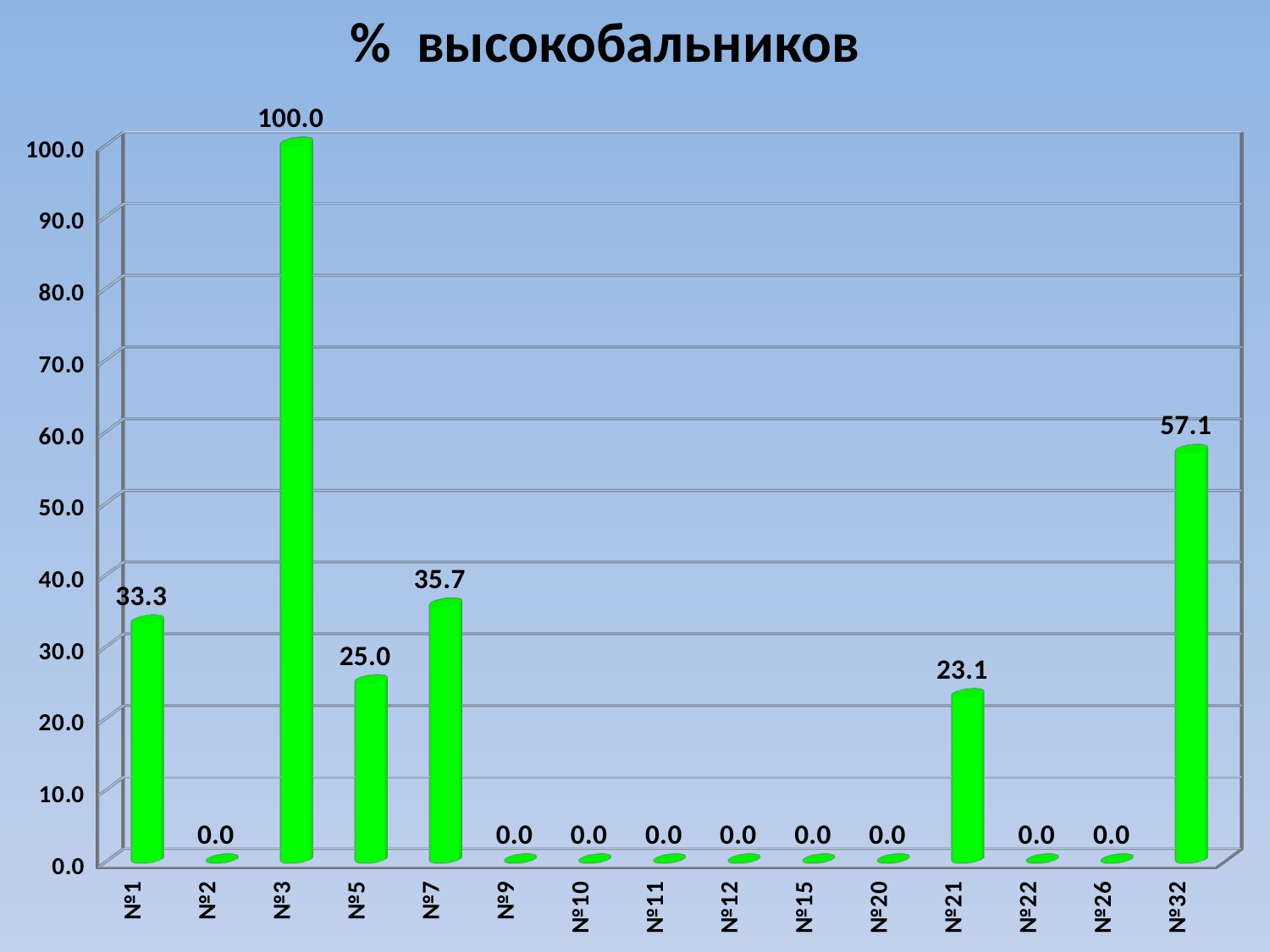
What is the value for №21? 23.1 Which category has the highest value? №3 What is the value for №32? 57.1 What is the value for №7? 35.7 Which is larger, the value for №1 or the value for №21? №1 What is the value for №3? 100.0 How many categories have a value of 0.0? 9 How many categories are shown on the x axis? 15 What is the difference between the values for №32 and №1? 23.8 What is the difference between the values for №7 and №5? 10.7 What kind of chart is this? bar chart What is the title of the chart? % высокобальников